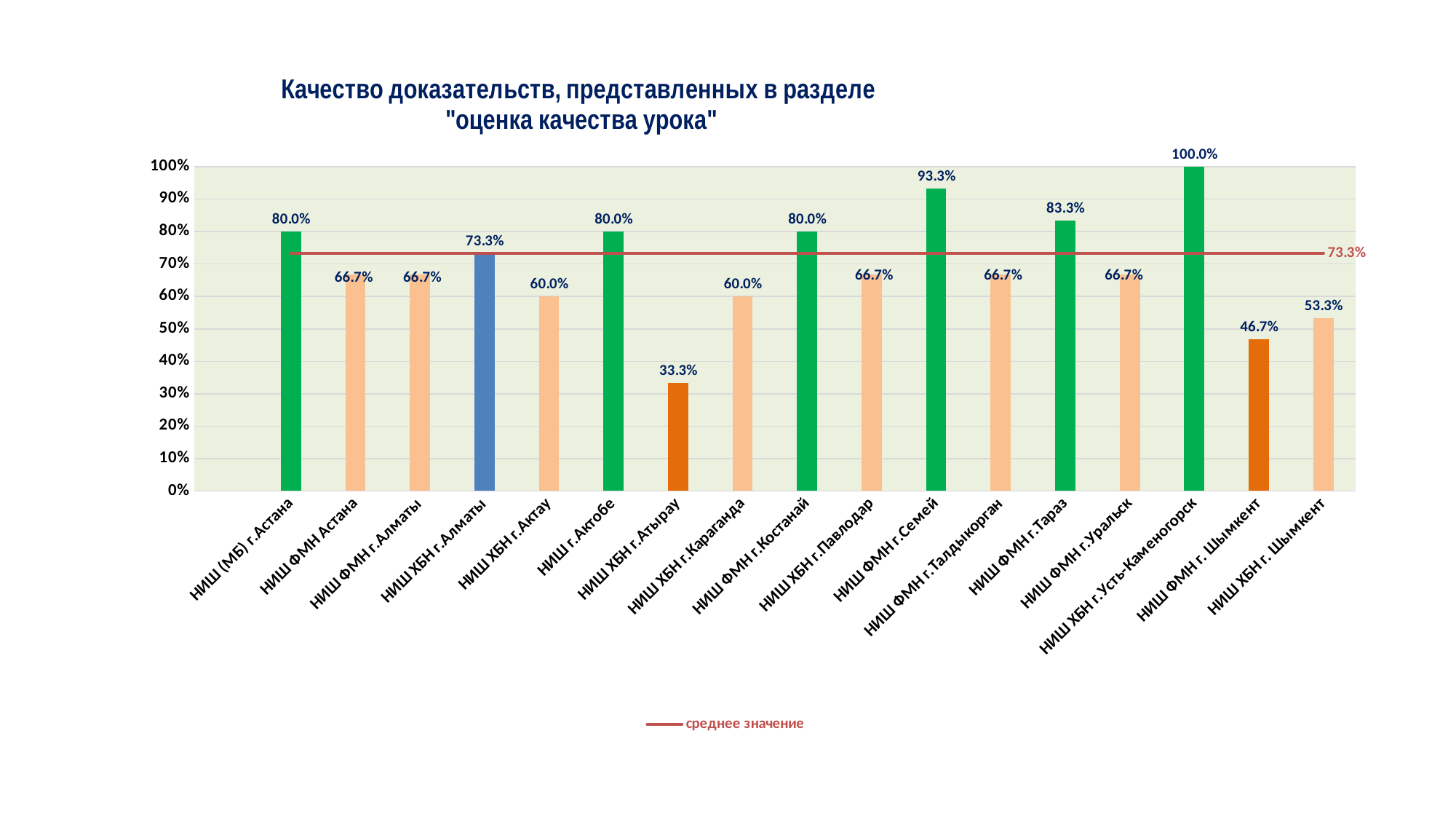
How many categories (bars) are shown on the chart? 17 What is the value for НИШ ХБН г.Атырау? 33.3% What is the value for НИШ ФМН г.Семей? 93.3% What is the difference between the values for НИШ ФМН г.Тараз and НИШ ХБН г. Шымкент? 30.0% What is the value for НИШ ФМН г. Шымкент? 46.7% Which is larger, the value for НИШ ФМН г.Костанай or the value for НИШ ХБН г.Караганда? НИШ ФМН г.Костанай What does the legend entry for the red horizontal line say? среднее значение What kind of chart is this? bar chart Which category has the highest value? НИШ ХБН г.Усть-Каменогорск Is the value for НИШ ХБН г.Актау greater or less than 70%? less What is the value shown for the average line (среднее значение)? 73.3% Which category has the lowest value? НИШ ХБН г.Атырау